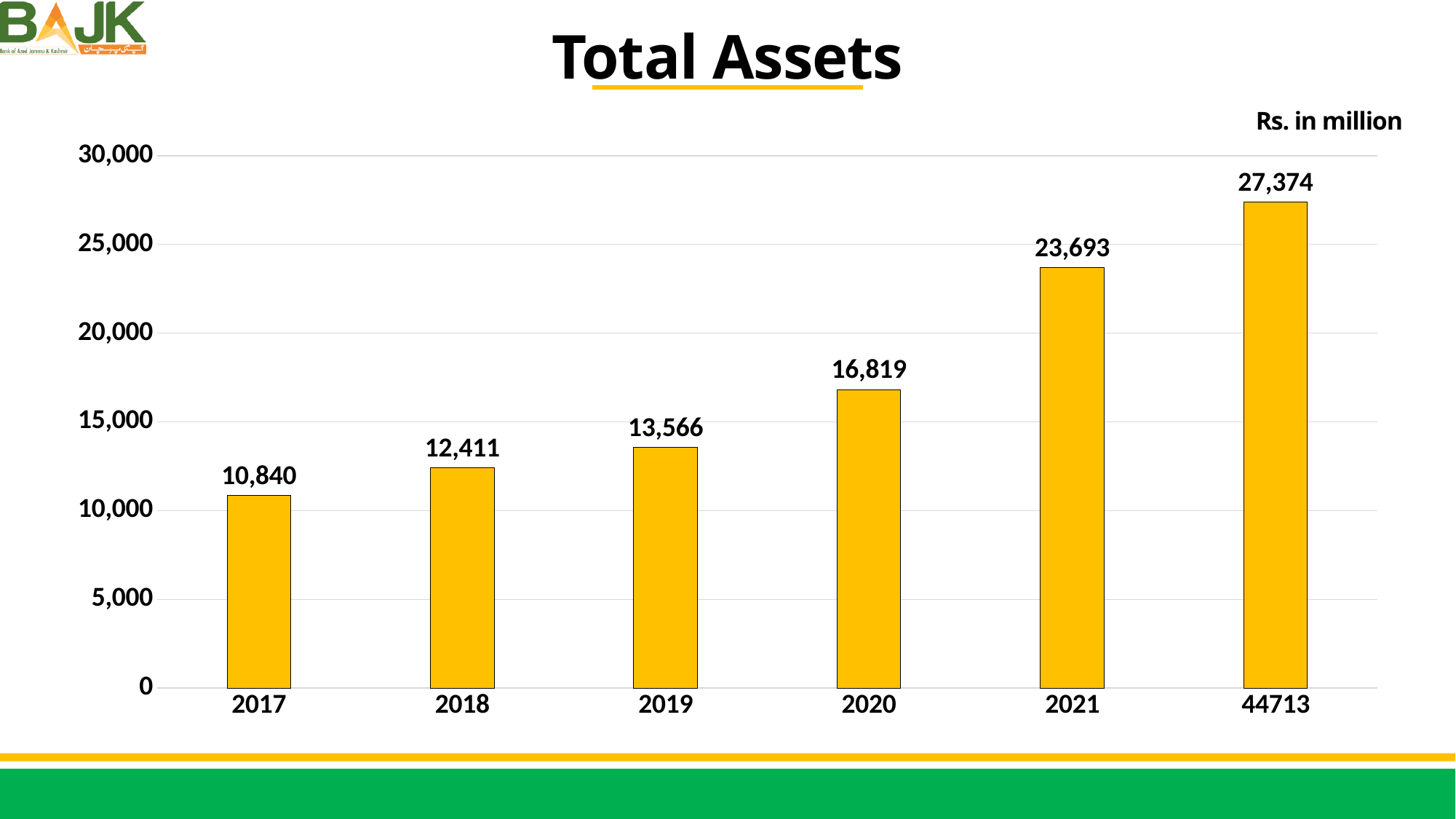
What is the value for 2017 in the Total Assets chart? 10,840 Which year has the lowest value in the Total Assets chart? 2017 What is the difference between the values for 2018 and 2017 in the Total Assets chart? 1,571 What is the value for the category labelled 44713 in the Total Assets chart? 27,374 What kind of chart is shown on the slide? Bar chart What is the value for 2021 in the Total Assets chart? 23,693 Which is larger in the Total Assets chart, the value for 2019 or the value for 2020? 2020 Which category has the highest value in the Total Assets chart? 44713 Do the values in the Total Assets chart rise or fall from left to right along the x axis? Rise How many bars are shown in the Total Assets chart? 6 What is the value for 2020 in the Total Assets chart? 16,819 What is the difference between the values for 2021 and 2020 in the Total Assets chart? 6,874